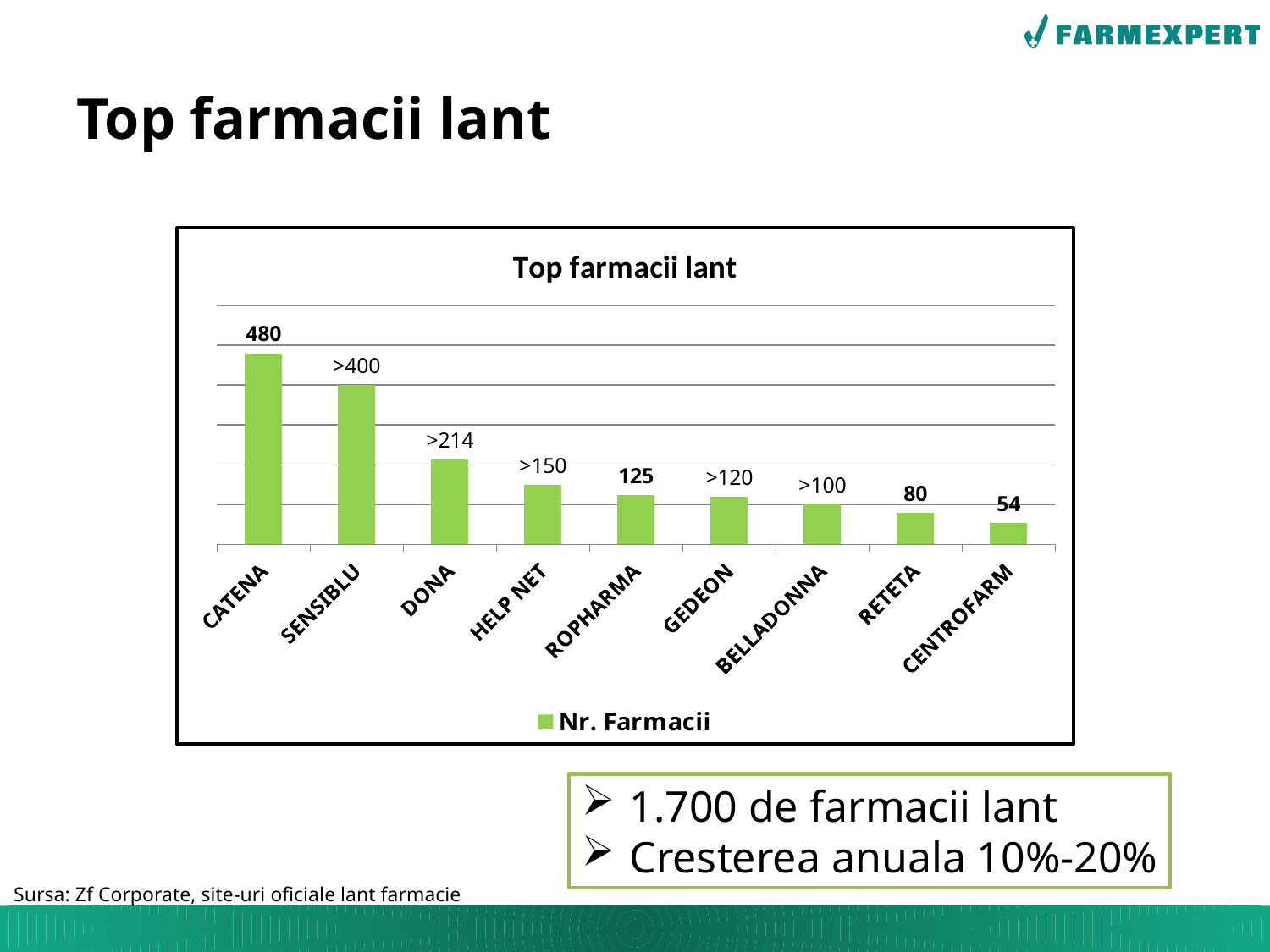
What value is shown for ROPHARMA? 125 What value is shown for CATENA? 480 Which category has the lowest value? CENTROFARM What value is shown for CENTROFARM? 54 What kind of chart is this? Bar chart What is the difference between the values for ROPHARMA and RETETA? 45 Which category has the highest value? CATENA What value is shown for DONA? >214 What value is shown for SENSIBLU? >400 What is the difference between the values for CATENA and CENTROFARM? 426 Which is larger, the value for HELP NET or the value for RETETA? HELP NET How many categories are shown on the x axis? 9